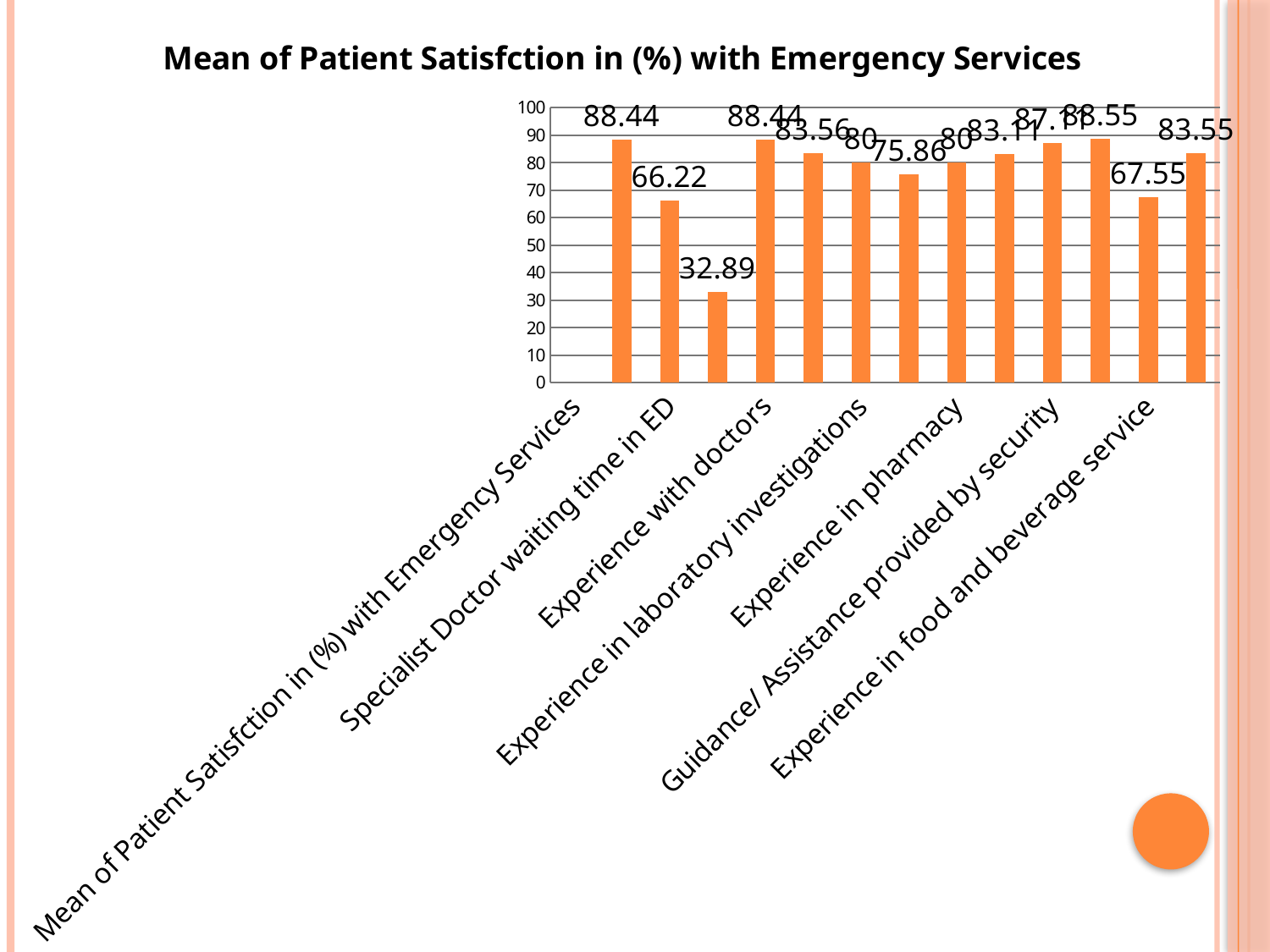
What is the value for Experience in pharmacy? 80 How many bars are plotted in the chart? 13 Which is larger, the value for Experience in pharmacy or for Experience in laboratory investigations? They are equal (both 80) What is the title of the chart? Mean of Patient Satisfction in (%) with Emergency Services What is the value for Specialist Doctor waiting time in ED? 66.22 Is the value for Specialist Doctor waiting time in ED greater or less than 40? greater What is the value for Experience in laboratory investigations? 80 What type of chart is shown on the slide? bar chart What is the difference between the value for Experience with doctors and the value for Specialist Doctor waiting time in ED? 22.22 What is the value for Experience with doctors? 88.44 What is the value for Experience in food and beverage service? 67.55